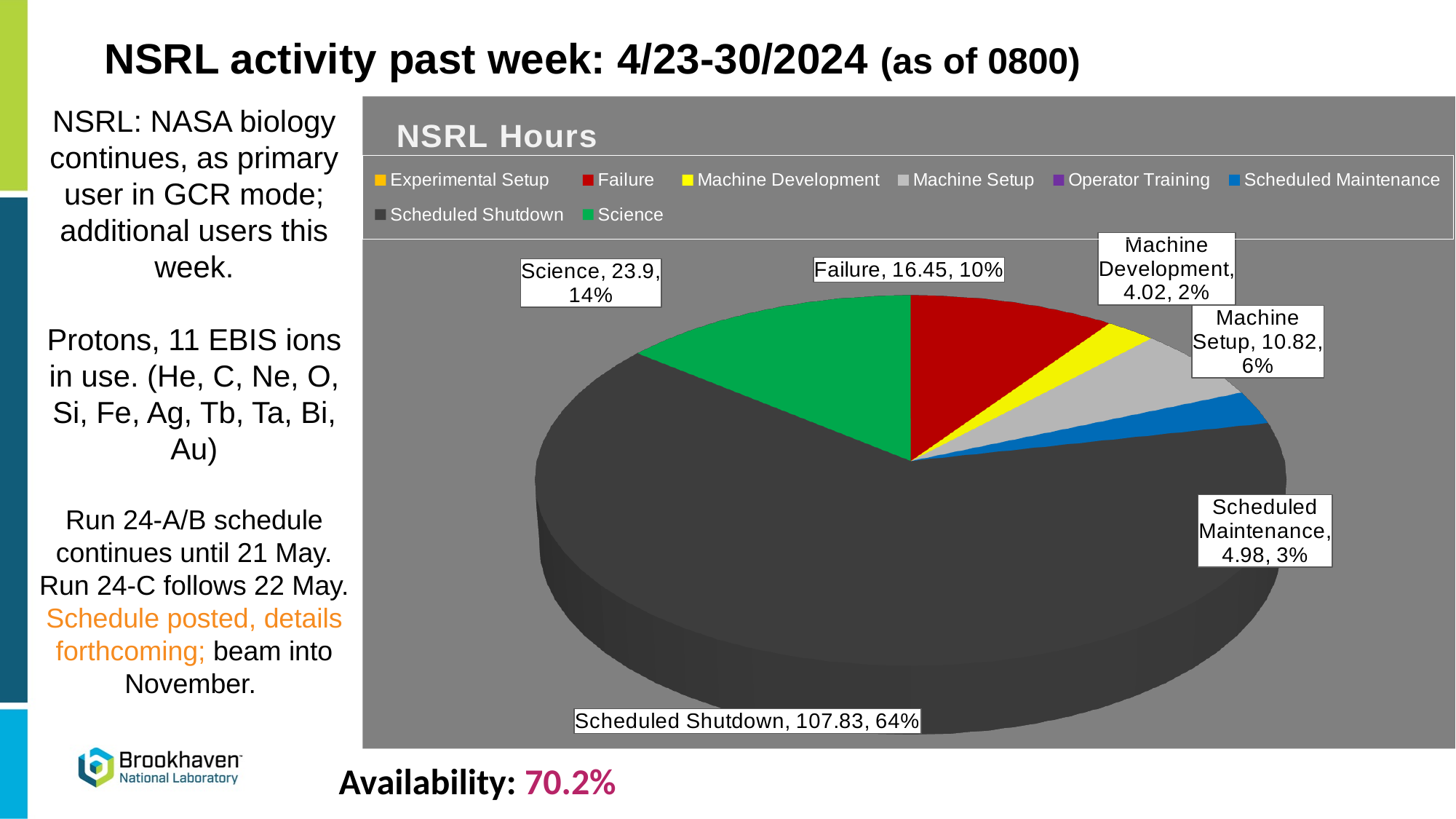
Which labelled category has the smallest slice of the pie? Machine Development Which labelled category has the largest slice of the pie? Scheduled Shutdown What is the title of the chart? NSRL Hours What is the difference in hours between Science and Failure? 7.45 What share of the pie does Scheduled Shutdown represent? 64% What share of the pie does Machine Setup represent? 6% Which has more hours, Machine Setup or Scheduled Maintenance? Machine Setup How many hours are shown for Failure? 16.45 How many series does the chart legend list? 8 What share of the pie does Science represent? 14% How many hours are shown for Scheduled Shutdown? 107.83 What type of chart is shown on the slide? Pie chart